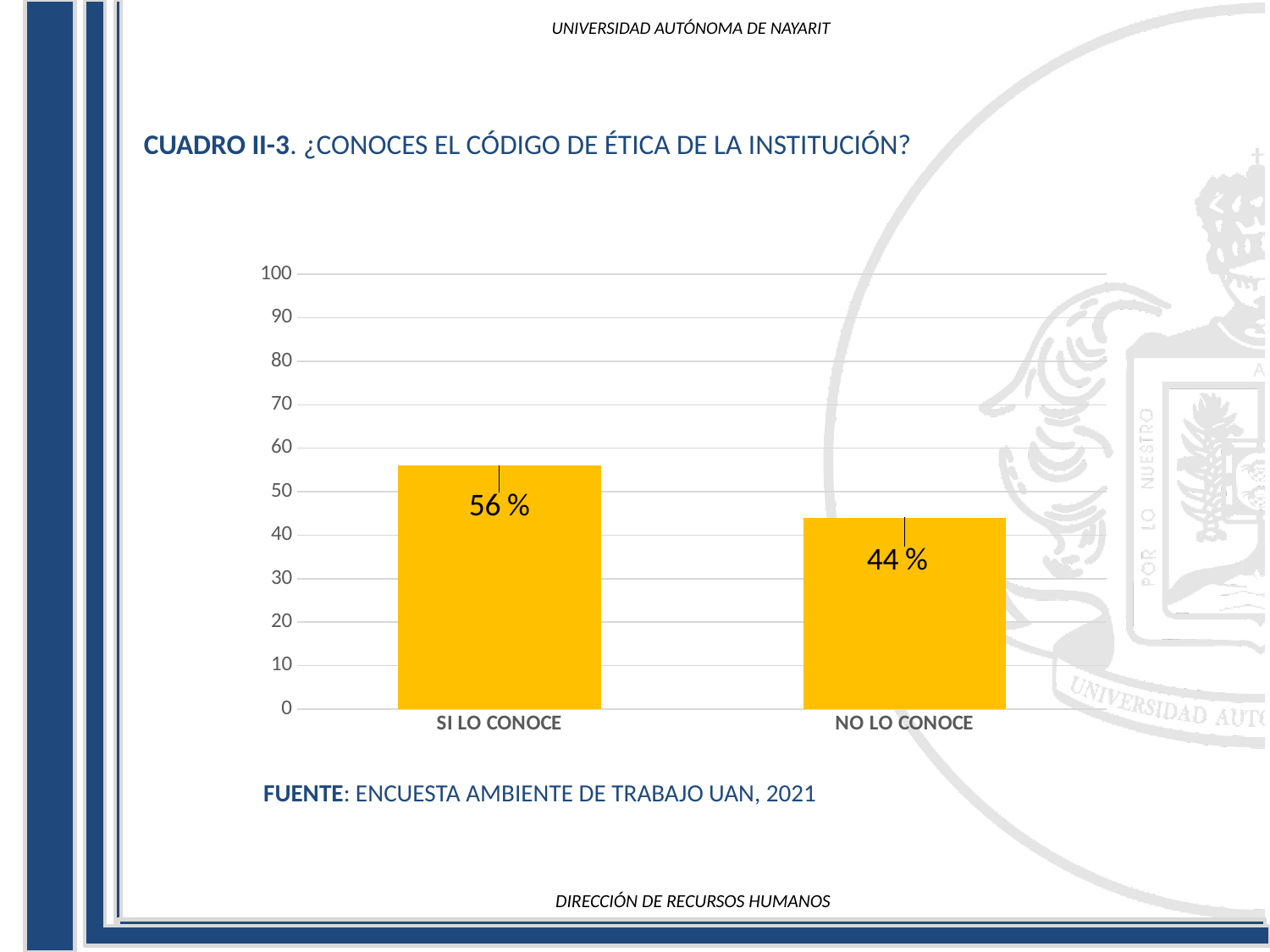
What is the value for SI LO CONOCE? 56 % What is the difference between the values for SI LO CONOCE and NO LO CONOCE? 12 % What is the maximum value shown on the vertical axis? 100 Which is larger, the value for SI LO CONOCE or the value for NO LO CONOCE? SI LO CONOCE Which category has the highest value? SI LO CONOCE Is the value for NO LO CONOCE greater or less than 50? less What is the value for NO LO CONOCE? 44 % What source is cited below the chart? ENCUESTA AMBIENTE DE TRABAJO UAN, 2021 What kind of chart is shown on the slide? bar chart How many categories are shown in the chart? 2 Which category has the lowest value? NO LO CONOCE Is the value for SI LO CONOCE greater or less than 50? greater